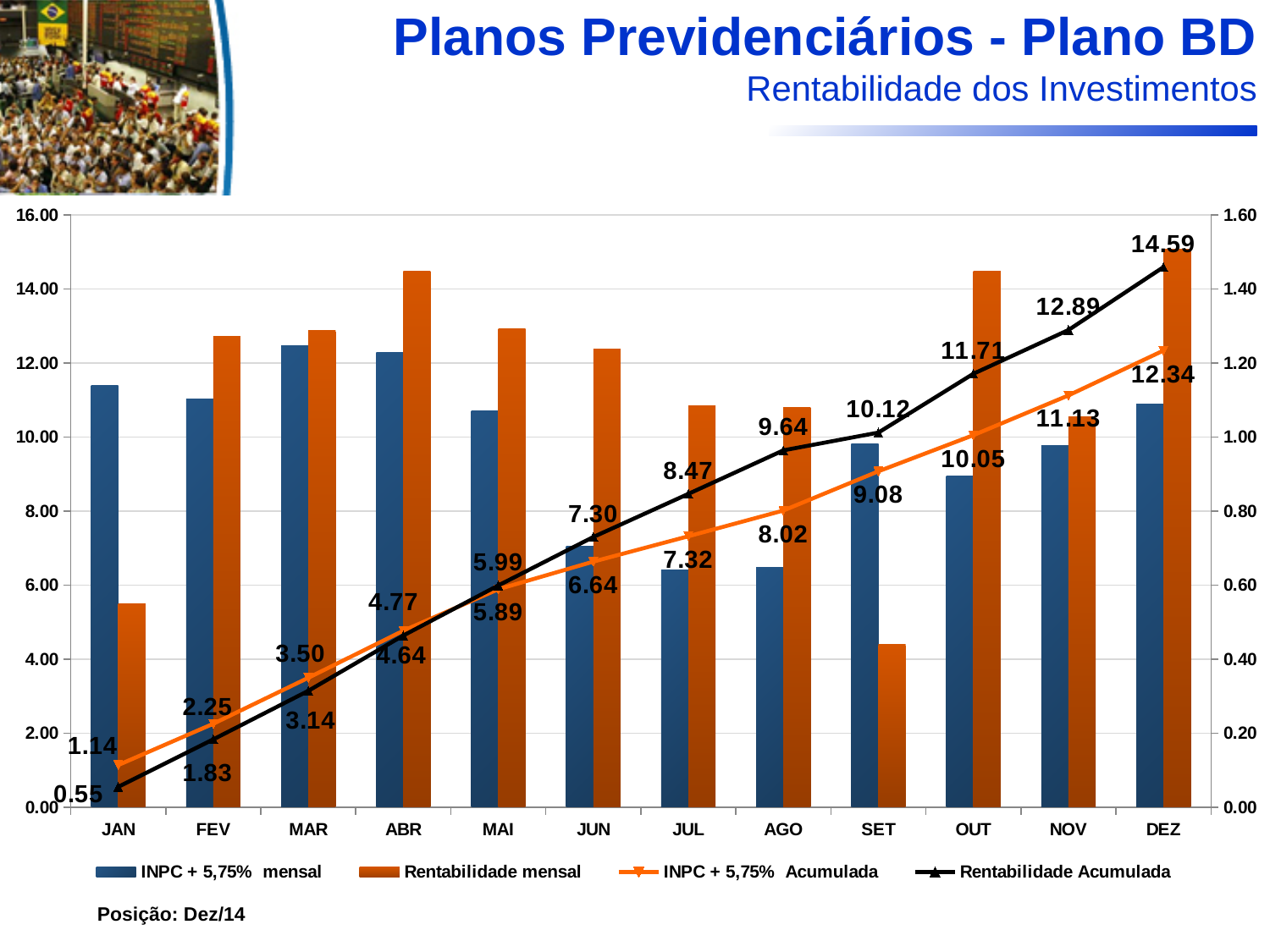
What is the value of INPC + 5,75% Acumulada in DEZ? 12.34 Is the Rentabilidade mensal bar for ABR greater or less than 14.00? greater How many series does the legend list? 4 What is the difference between Rentabilidade Acumulada and INPC + 5,75% Acumulada in DEZ? 2.25 In OUT, which is larger: Rentabilidade Acumulada or INPC + 5,75% Acumulada? Rentabilidade Acumulada What is the value of Rentabilidade Acumulada in JAN? 0.55 What is the value of INPC + 5,75% Acumulada in SET? 9.08 What is the value of Rentabilidade Acumulada in DEZ? 14.59 How many months are shown on the x axis? 12 What kind of chart is this? Combined bar and line chart Is the Rentabilidade mensal bar for SET greater or less than 6.00? less Does the Rentabilidade Acumulada line rise or fall from JAN to DEZ? Rises